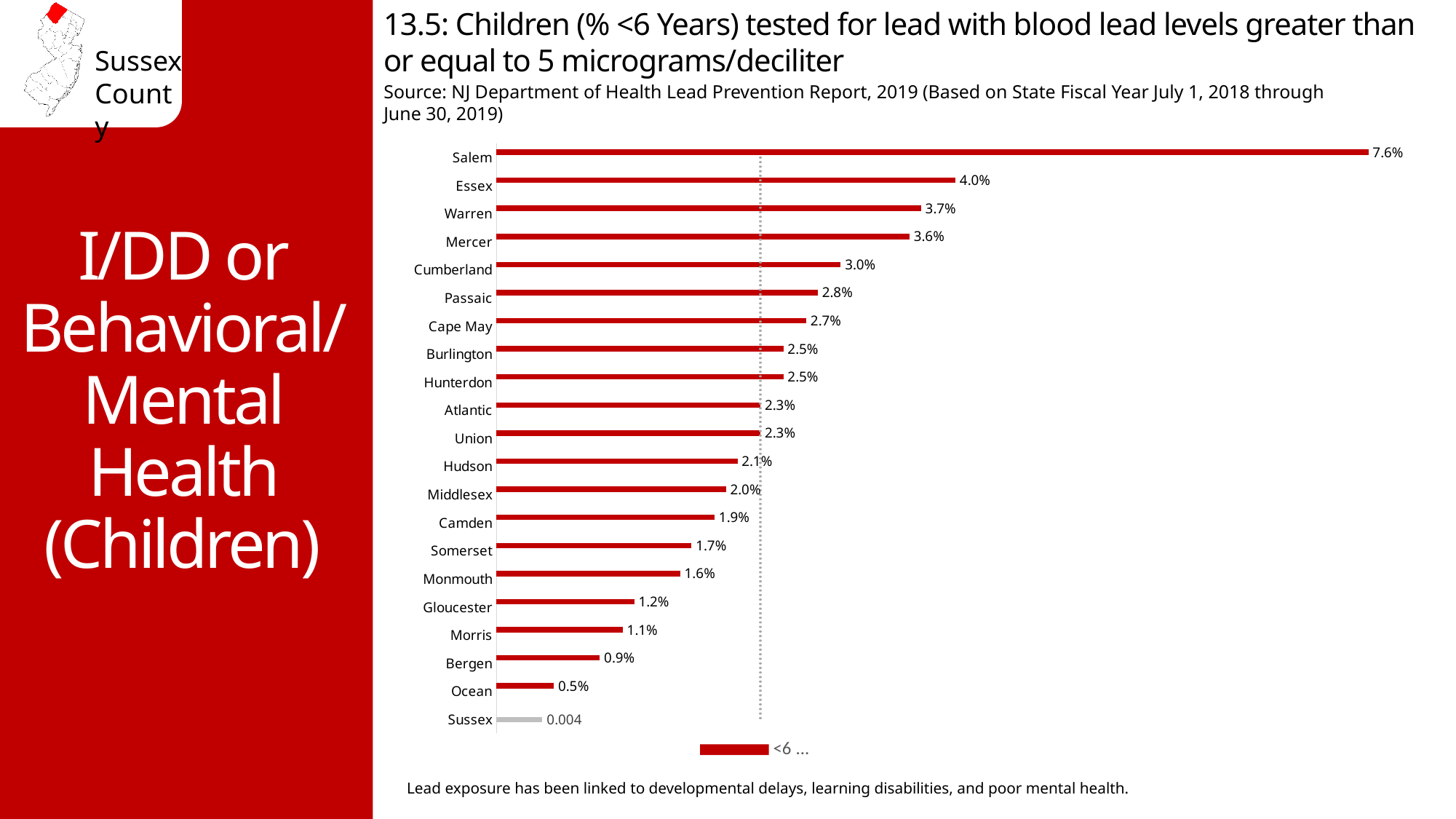
What value is printed next to the Sussex bar? 0.004 What is the difference between the values for Bergen and Ocean? 0.4% Which county has the lowest value? Sussex What is the value for Monmouth? 1.6% What is the value for Salem? 7.6% What is the value for Cumberland? 3.0% What is the difference between the values for Salem and Essex? 3.6% Which has a larger value, Passaic or Camden? Passaic Which county's bar is drawn in grey rather than red? Sussex Which county has the highest value? Salem How many counties are shown in the chart? 21 What kind of chart is shown on the slide? Bar chart